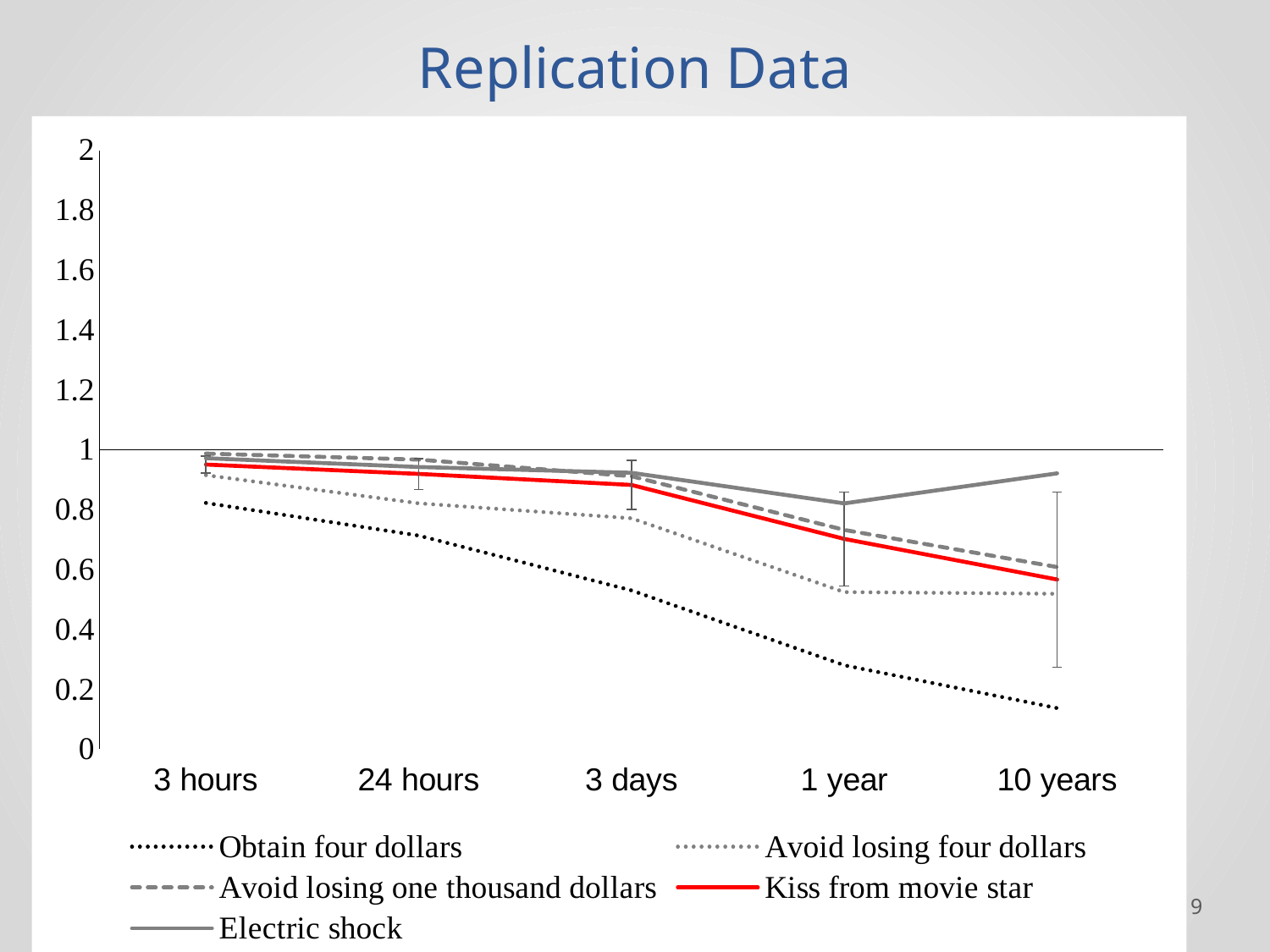
Which series has the highest value at 10 years? Electric shock What is the title of the slide's chart? Replication Data Is the value for Electric shock at 10 years greater or less than 0.8? greater Is the value for Obtain four dollars at 10 years greater or less than 0.2? less Do the values for Obtain four dollars rise or fall from 3 hours to 10 years? fall Which series is drawn as a solid red line? Kiss from movie star Which series has the lowest value at 10 years? Obtain four dollars What kind of chart is shown on the slide? line chart At 1 year, which is larger: Electric shock or Obtain four dollars? Electric shock How many time points are shown on the x axis? 5 Is the value for Obtain four dollars at 1 year greater or less than 0.4? less How many series does the legend list? 5